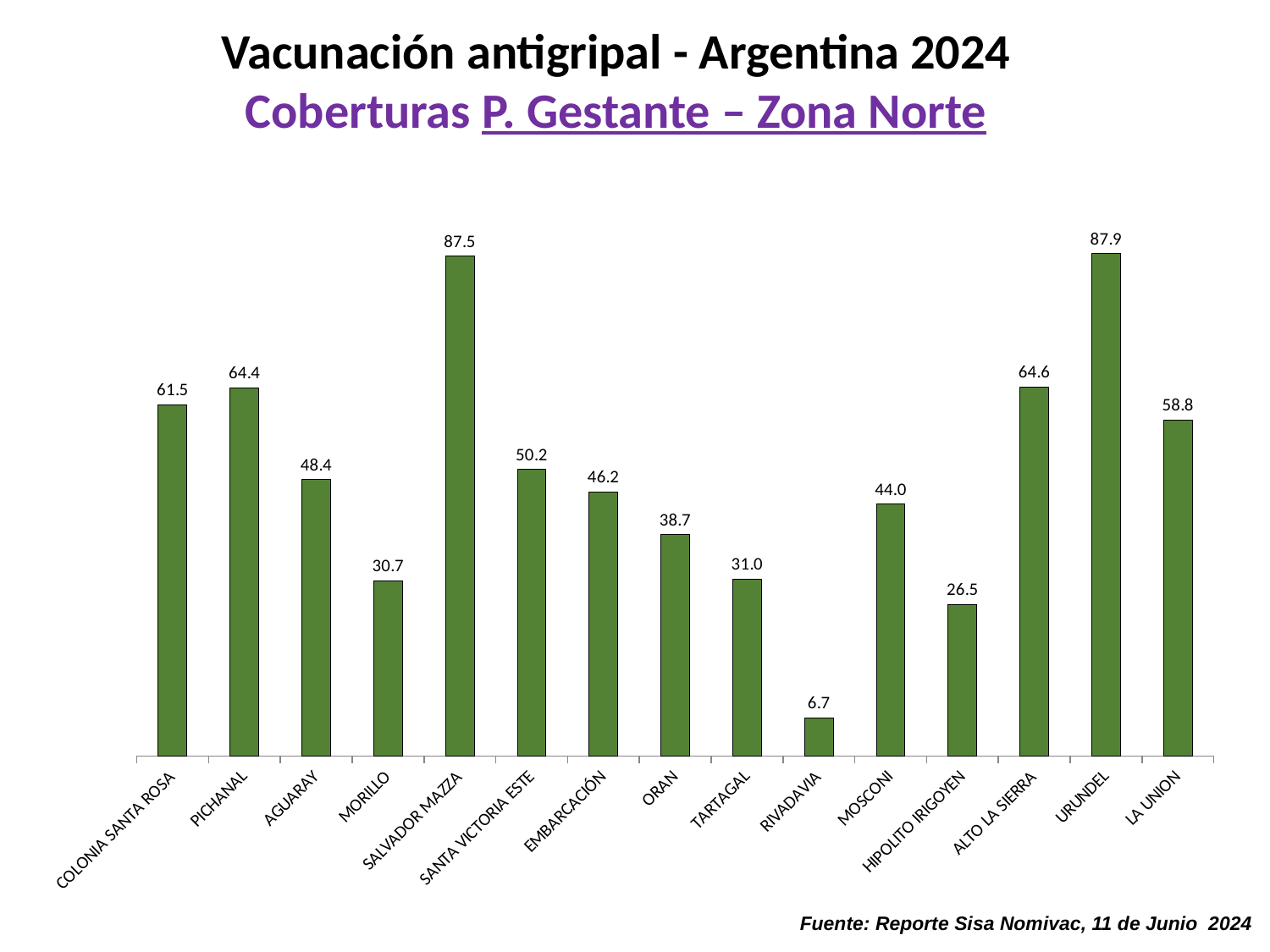
Which locality has the highest coverage value? URUNDEL What is the coverage value for LA UNION? 58.8 How many localities are shown on the chart? 15 What is the coverage value for RIVADAVIA? 6.7 What is the difference between the values for PICHANAL and AGUARAY? 16.0 What is the coverage value for HIPOLITO IRIGOYEN? 26.5 What kind of chart is shown on the slide? Bar chart What is the difference between the values for URUNDEL and SALVADOR MAZZA? 0.4 What colour are the bars in the chart? Green What is the coverage value for SALVADOR MAZZA? 87.5 Which locality has the lowest coverage value? RIVADAVIA Which has a larger value, MOSCONI or ORAN? MOSCONI